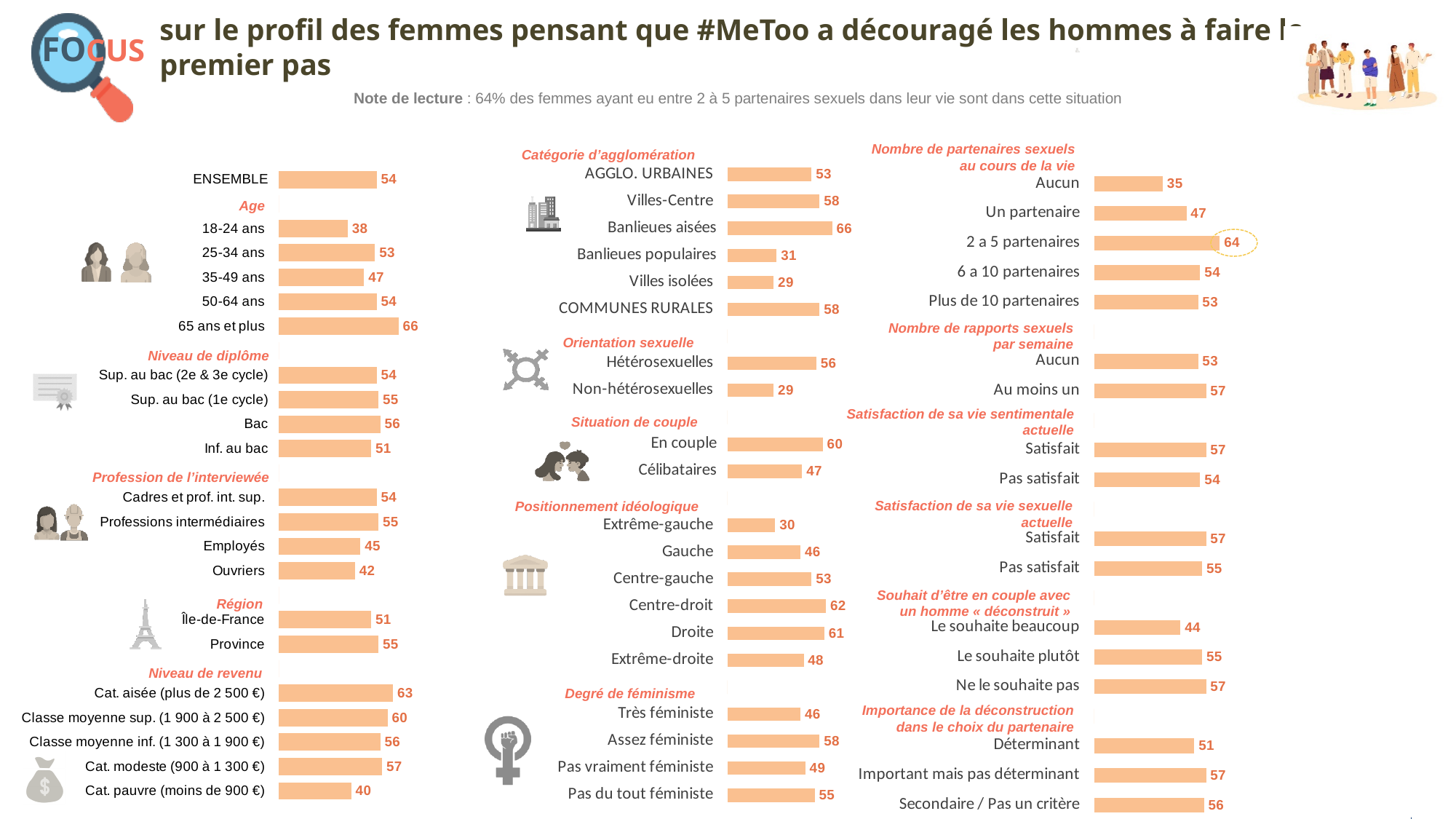
In the "Niveau de revenu" chart, what is the difference between "Cat. aisée (plus de 2 500 €)" and "Cat. pauvre (moins de 900 €)"? 23 In the "Orientation sexuelle" chart, what is the value for "Non-hétérosexuelles"? 29 In the "Age" chart, which age group has the lowest value? 18-24 ans In the "Age" chart, what is the value for "65 ans et plus"? 66 How many categories are shown in the "Positionnement idéologique" chart? 6 What type of chart is used throughout the slide? Bar chart In the "Catégorie d'agglomération" chart, what is the difference between "Villes-Centre" and "Villes isolées"? 29 What is the value for "ENSEMBLE" at the top of the left column? 54 In the "Catégorie d'agglomération" chart, which category has the highest value? Banlieues aisées In the "Positionnement idéologique" chart, which is larger: "Centre-droit" or "Extrême-gauche"? Centre-droit In the "Niveau de revenu" chart, what is the value for "Cat. pauvre (moins de 900 €)"? 40 In the "Nombre de partenaires sexuels au cours de la vie" chart, what is the value for "2 a 5 partenaires"? 64